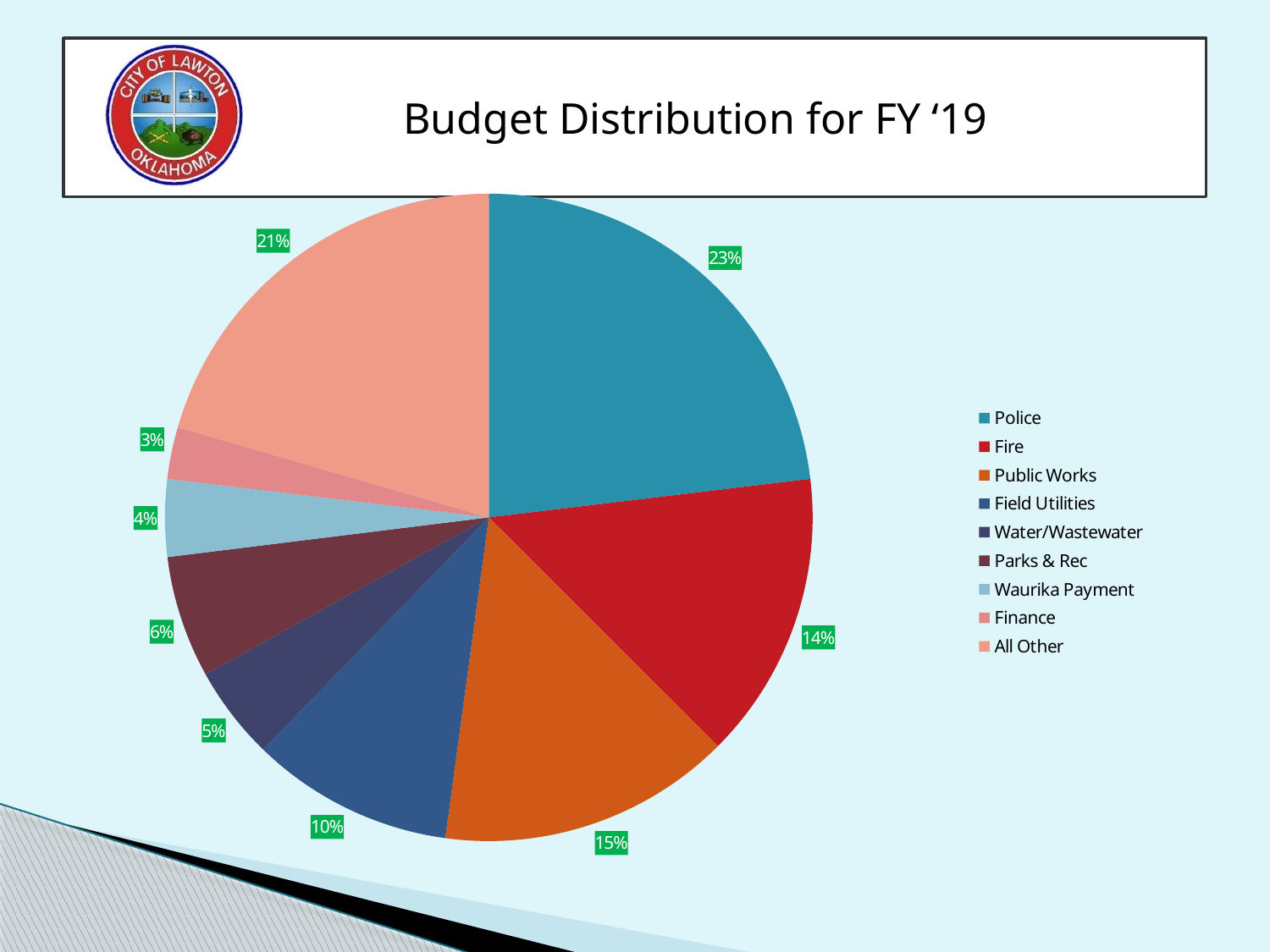
What is the title of the chart? Budget Distribution for FY '19 Which category receives the smallest share of the FY '19 budget? Finance What percentage of the budget is the Waurika Payment? 4% Which receives a larger share of the budget, Field Utilities or Parks & Rec? Field Utilities What percentage of the budget is allocated to Fire? 14% What type of chart is shown on the slide? Pie chart How many percentage points larger is the Police share than the Fire share? 9 How many categories does the pie chart show? 9 What share of the FY '19 budget goes to Police? 23% Which category receives the largest share of the FY '19 budget? Police What share of the budget goes to Finance? 3% What share of the budget does Public Works receive? 15%